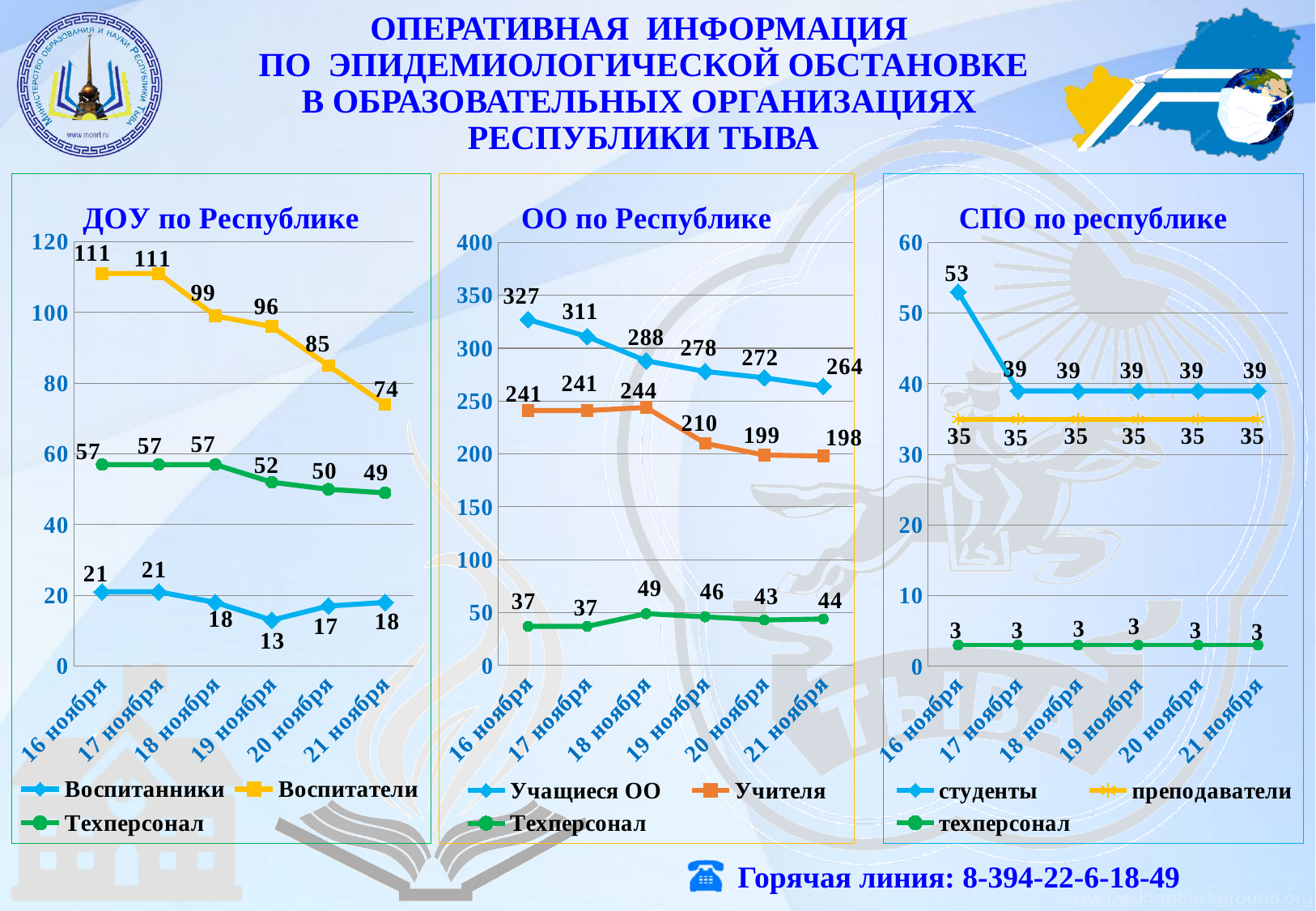
In the 'ДОУ по Республике' chart, does the Воспитатели series rise or fall from 16 ноября to 21 ноября? fall In the 'ОО по Республике' chart, what is the difference between the Учителя values on 18 ноября and 19 ноября? 34 What kind of chart is 'ДОУ по Республике'? line chart How many dates are shown on the x axis of the 'СПО по республике' chart? 6 In the 'ДОУ по Республике' chart, what is the value for Воспитатели on 18 ноября? 99 In the 'ОО по Республике' chart, which is larger on 19 ноября: Учителя or Техперсонал? Учителя In the 'СПО по республике' chart, what is the value for студенты on 16 ноября? 53 In the 'ДОУ по Республике' chart, on which date is the value for Воспитанники lowest? 19 ноября In the 'ОО по Республике' chart, what is the value for Учащиеся ОО on 21 ноября? 264 In the 'СПО по республике' chart, how many series does the legend list? 3 In the 'ОО по Республике' chart, on which date is the value for Техперсонал highest? 18 ноября In the 'ДОУ по Республике' chart, what is the difference between the Воспитатели values on 16 ноября and 21 ноября? 37